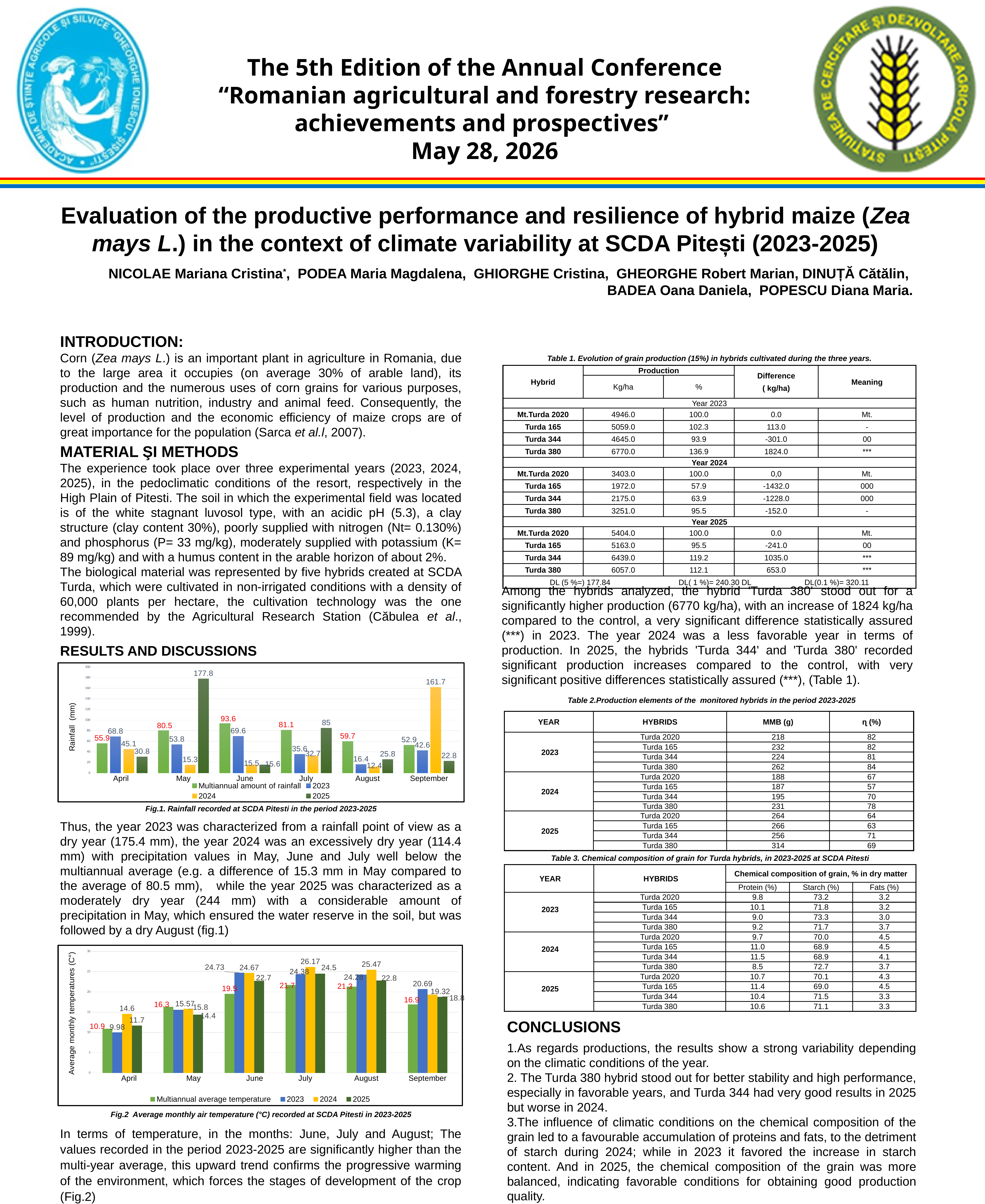
In the rainfall chart (Fig.1), what is the difference between the multiannual amount of rainfall and the 2024 value for May? 65.2 In the rainfall chart (Fig.1), how many series does the legend list? 4 In the temperature chart (Fig.2), which is larger for June: the 2023 value or the multiannual average temperature? 2023 In the temperature chart (Fig.2), what is the difference between the 2024 and 2023 values for April? 4.62 In the rainfall chart (Fig.1), what is the 2024 rainfall value for September? 161.7 In the rainfall chart (Fig.1), which month has the highest multiannual amount of rainfall? June In the temperature chart (Fig.2), what is the 2024 value for July? 26.17 In the rainfall chart (Fig.1), which month has the lowest 2024 rainfall value? August In the rainfall chart (Fig.1), how many months are shown on the x axis? 6 In the rainfall chart (Fig.1), what is the 2025 rainfall value for May? 177.8 In the temperature chart (Fig.2), which month has the lowest 2023 value? April What kind of chart is Fig.2 (average monthly air temperature)? Bar chart